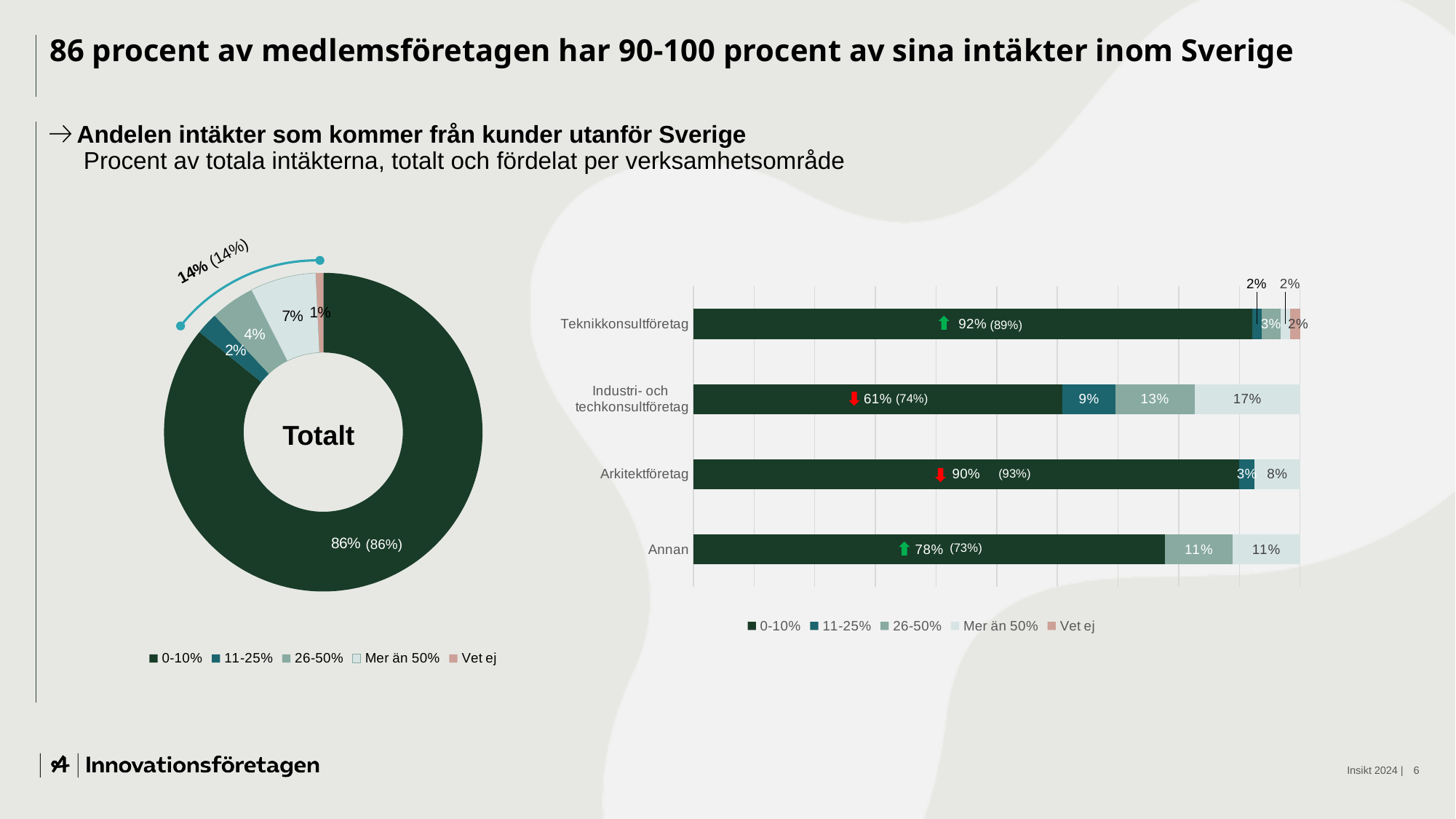
What kind of chart is shown on the right side of the slide? Stacked horizontal bar chart In the donut chart on the left, which category has the smallest share? Vet ej In the donut chart on the left, how many entries does the legend list? 5 In the donut chart on the left, what share of companies fall in the 0-10% category? 86% In the bar chart on the right, how many categories are shown on the vertical axis? 4 In the donut chart on the left, what is the difference between the 26-50% share and the 11-25% share? 2% In the bar chart on the right, what is the 'Mer än 50%' value for Annan? 11% In the bar chart on the right, what is the 0-10% value for Industri- och techkonsultföretag? 61% In the bar chart on the right, which is larger: the 0-10% value for Arkitektföretag or for Annan? Arkitektföretag In the donut chart on the left, what share is shown for the 'Mer än 50%' category? 7% In the bar chart on the right, which category has the lowest 0-10% value? Industri- och techkonsultföretag In the bar chart on the right, which category has the highest 0-10% value? Teknikkonsultföretag